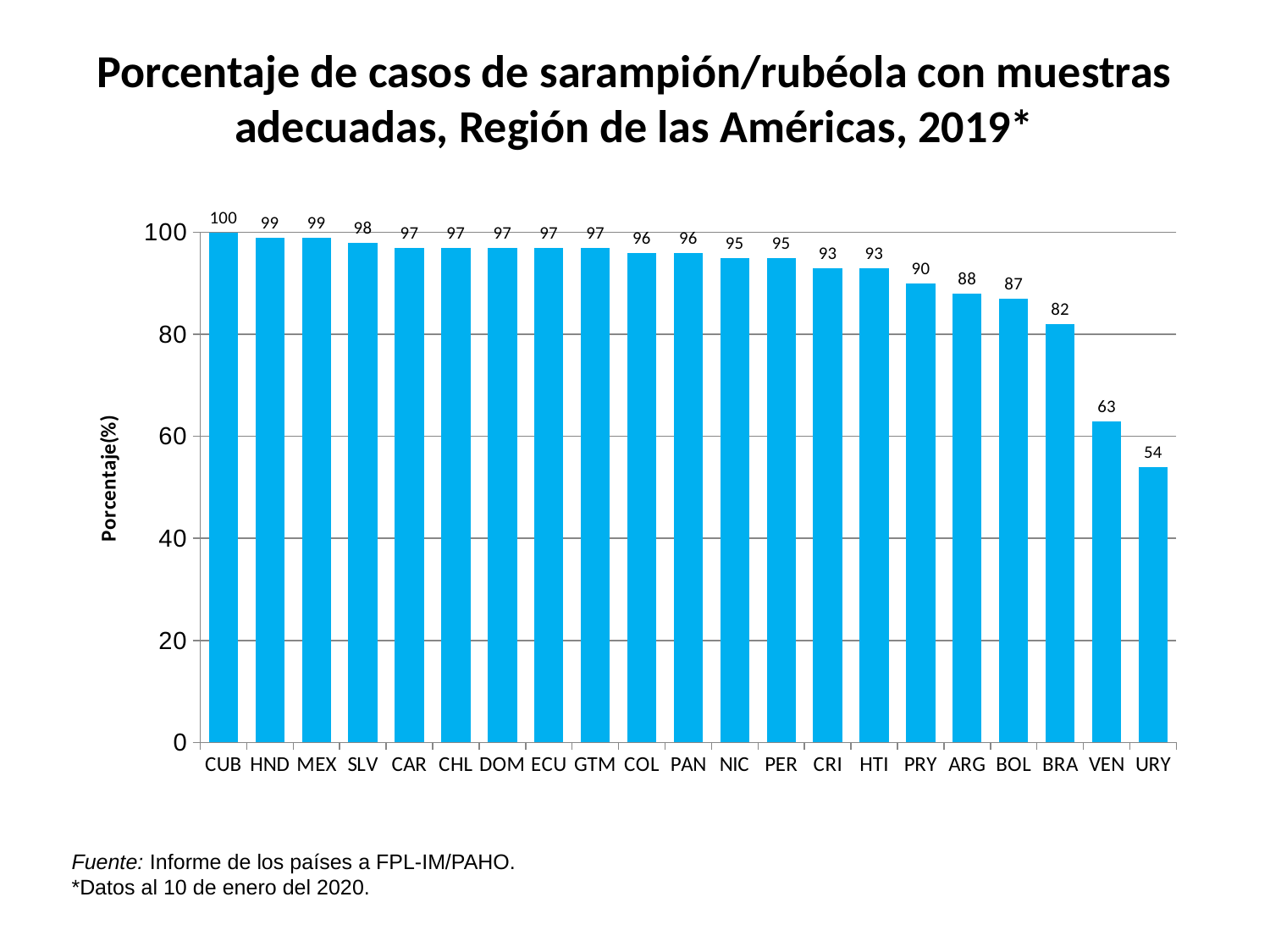
Which is larger, the value for ARG or the value for BOL? ARG What is the value for VEN? 63 Do the values rise or fall from left to right along the x axis? fall Which country has the lowest value? URY What is the value for BRA? 82 What kind of chart is shown on the slide? bar chart Which country has the highest value? CUB Is the value for URY greater or less than 60? less How many countries are shown on the x axis? 21 What is the difference between the values for CUB and URY? 46 What is the difference between the values for BRA and VEN? 19 What is the value for PRY? 90